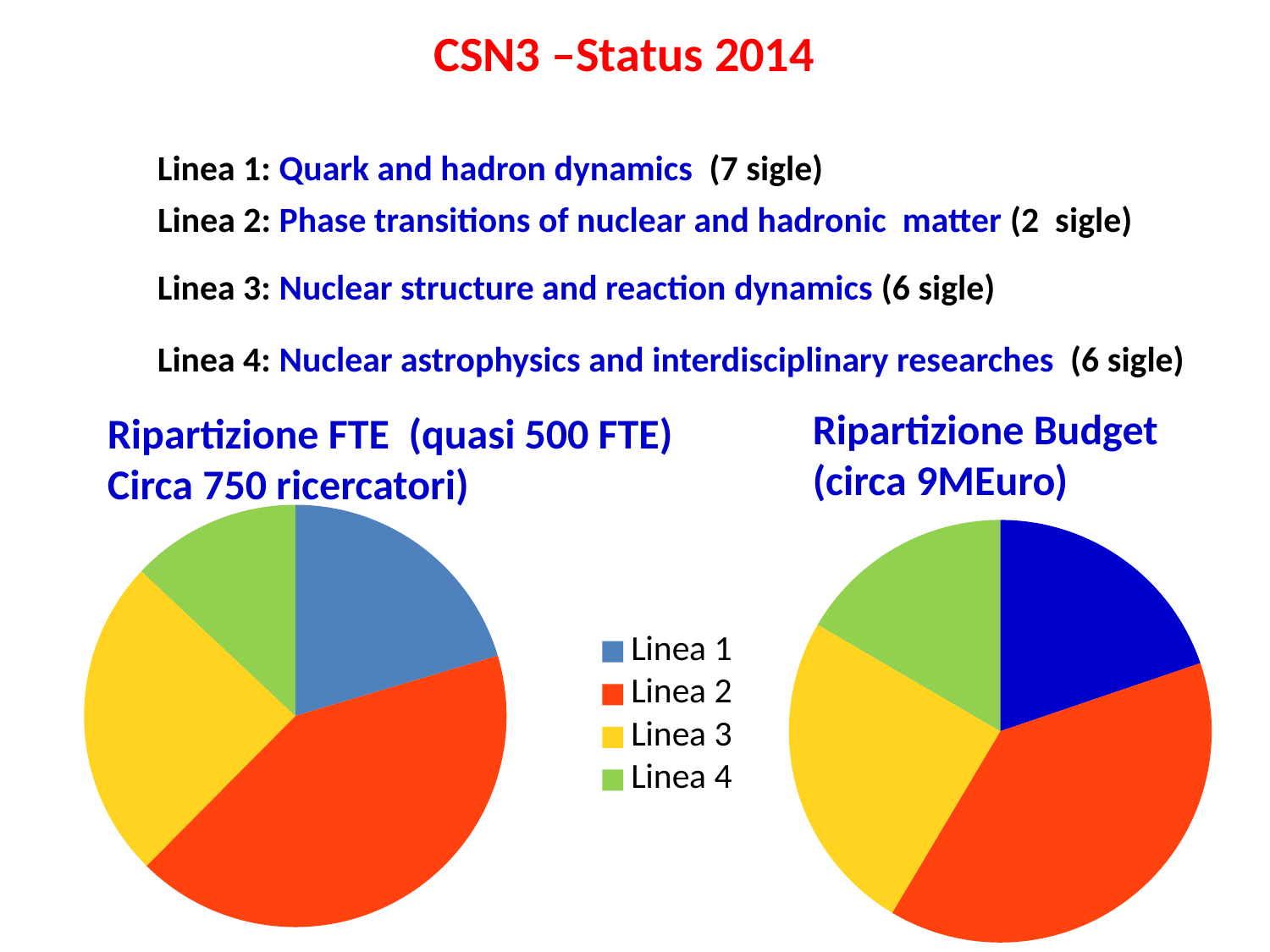
In the 'Ripartizione FTE' chart on the left, which Linea has the largest slice? Linea 2 How many entries does the legend between the two pie charts list? 4 According to the legend, which colour represents Linea 3? yellow What is the title of the pie chart on the right? Ripartizione Budget (circa 9MEuro) In the 'Ripartizione FTE' chart on the left, which Linea has the smallest slice? Linea 4 In the 'Ripartizione FTE' chart on the left, which slice is larger, Linea 2 or Linea 3? Linea 2 What kind of chart is the 'Ripartizione Budget' chart on the right? pie chart What kind of chart is the 'Ripartizione FTE' chart on the left? pie chart In the 'Ripartizione Budget' chart on the right, which slice is larger, Linea 1 or Linea 4? Linea 1 In the 'Ripartizione Budget' chart on the right, which Linea has the smallest slice? Linea 4 How many slices does the 'Ripartizione FTE' pie chart on the left have? 4 In the 'Ripartizione Budget' chart on the right, which Linea has the largest slice? Linea 2